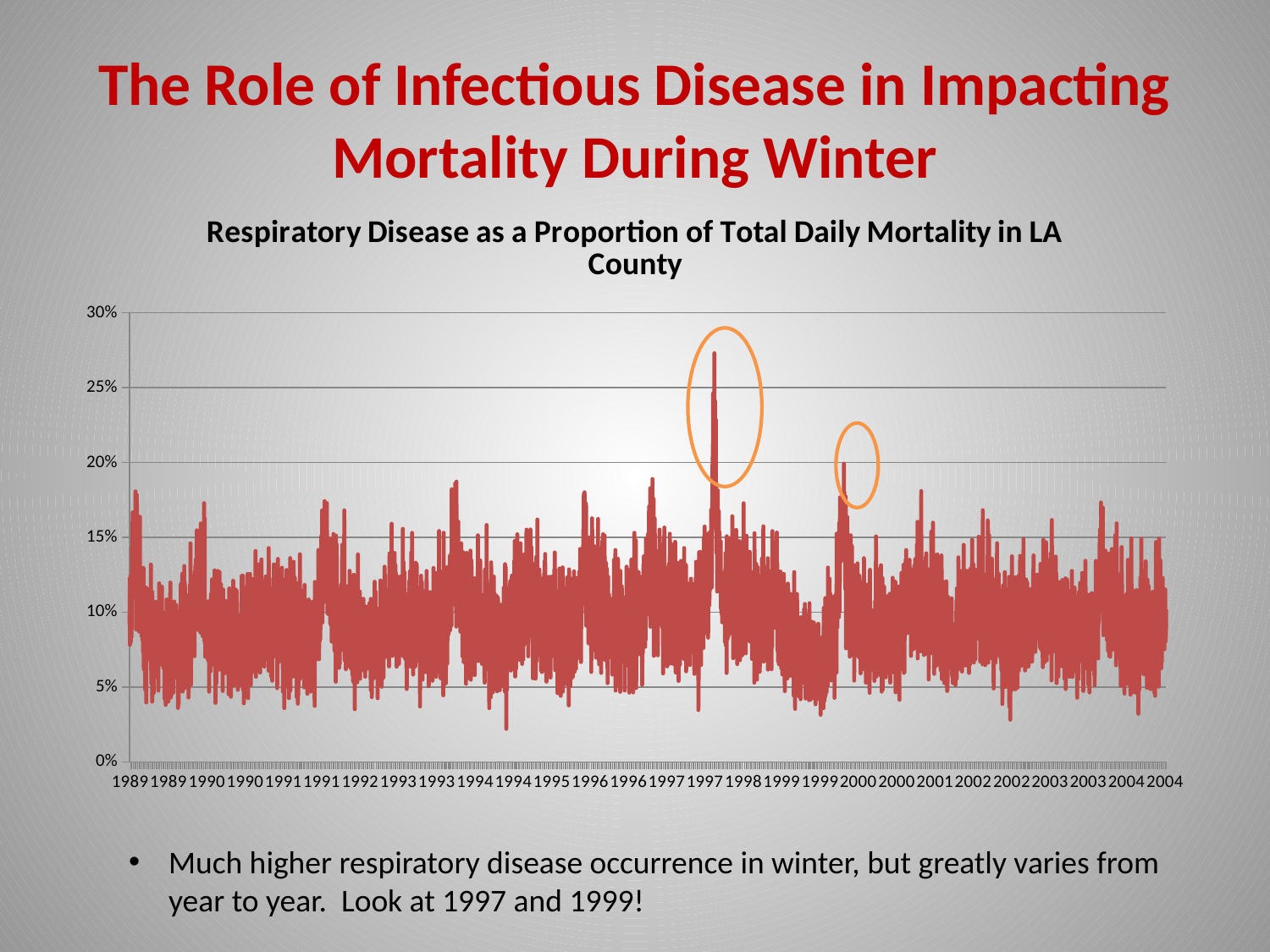
Is the highest peak in 1997 greater or less than 25%? greater What kind of chart is shown on the slide? line chart In which year does the chart reach its highest peak? 1997 What is the title of the chart? Respiratory Disease as a Proportion of Total Daily Mortality in LA County What is the last year shown on the horizontal axis? 2004 Is the peak in 1999 greater or less than 15%? greater Which peak is larger, the one in 1997 or the one in 1999? 1997 How many peaks are circled on the chart? 2 What is the highest value shown on the vertical axis? 30% Does the line ever rise above 30%? No What is the first year shown on the horizontal axis? 1989